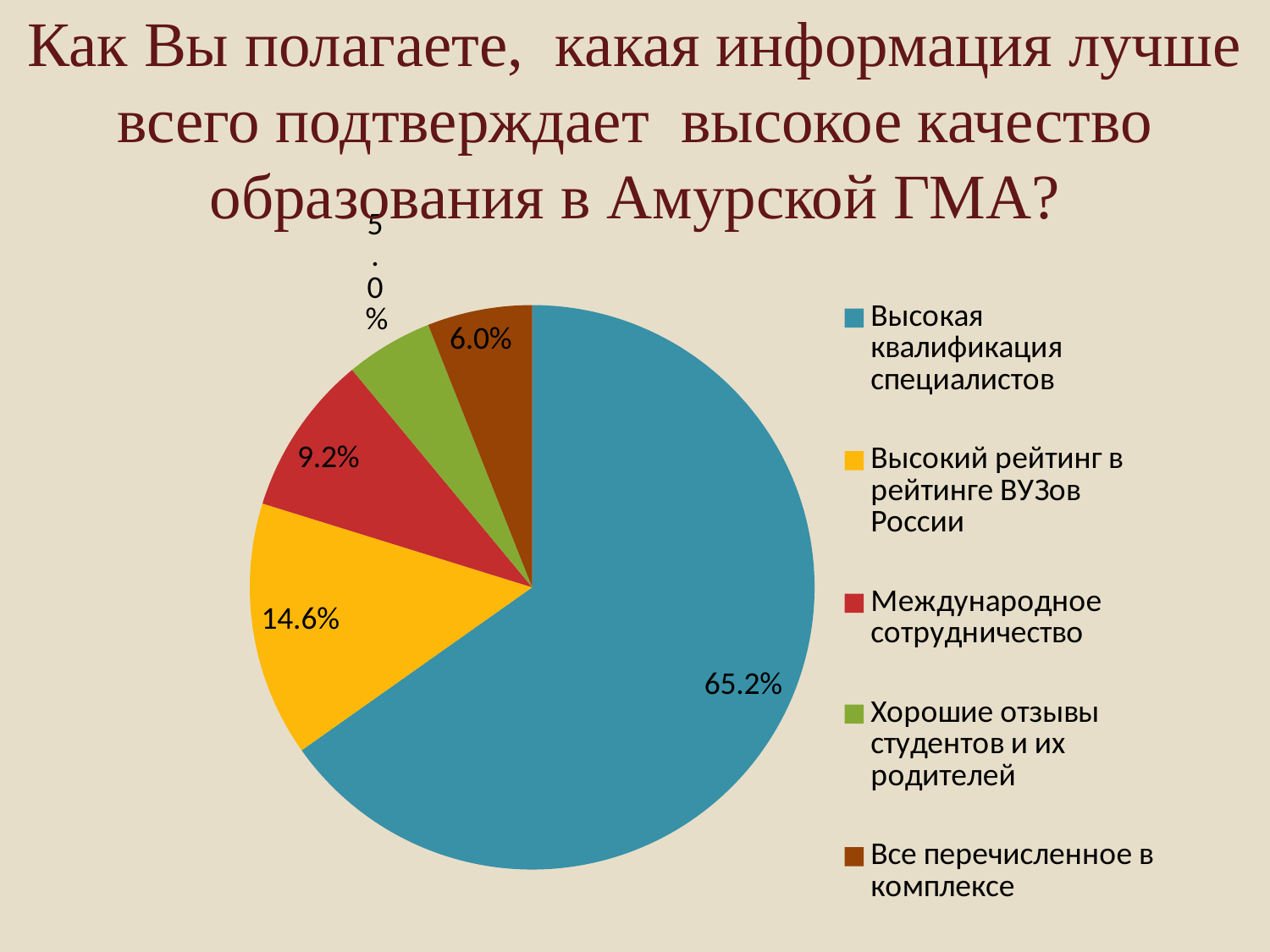
What value is shown for "Все перечисленное в комплексе"? 6.0% What value is shown for "Международное сотрудничество"? 9.2% How many categories does the pie chart have? 5 Which category has the smallest slice of the pie? Хорошие отзывы студентов и их родителей What kind of chart is shown on the slide? pie chart What colour is the slice for "Международное сотрудничество"? red What is the difference between the values for "Высокая квалификация специалистов" and "Высокий рейтинг в рейтинге ВУЗов России"? 50.6% What share of the pie is labelled for "Высокая квалификация специалистов"? 65.2% What value is shown for "Высокий рейтинг в рейтинге ВУЗов России"? 14.6% Which category has the largest slice of the pie? Высокая квалификация специалистов What value is shown for "Хорошие отзывы студентов и их родителей"? 5.0% Which is larger: the slice for "Международное сотрудничество" or the slice for "Все перечисленное в комплексе"? Международное сотрудничество